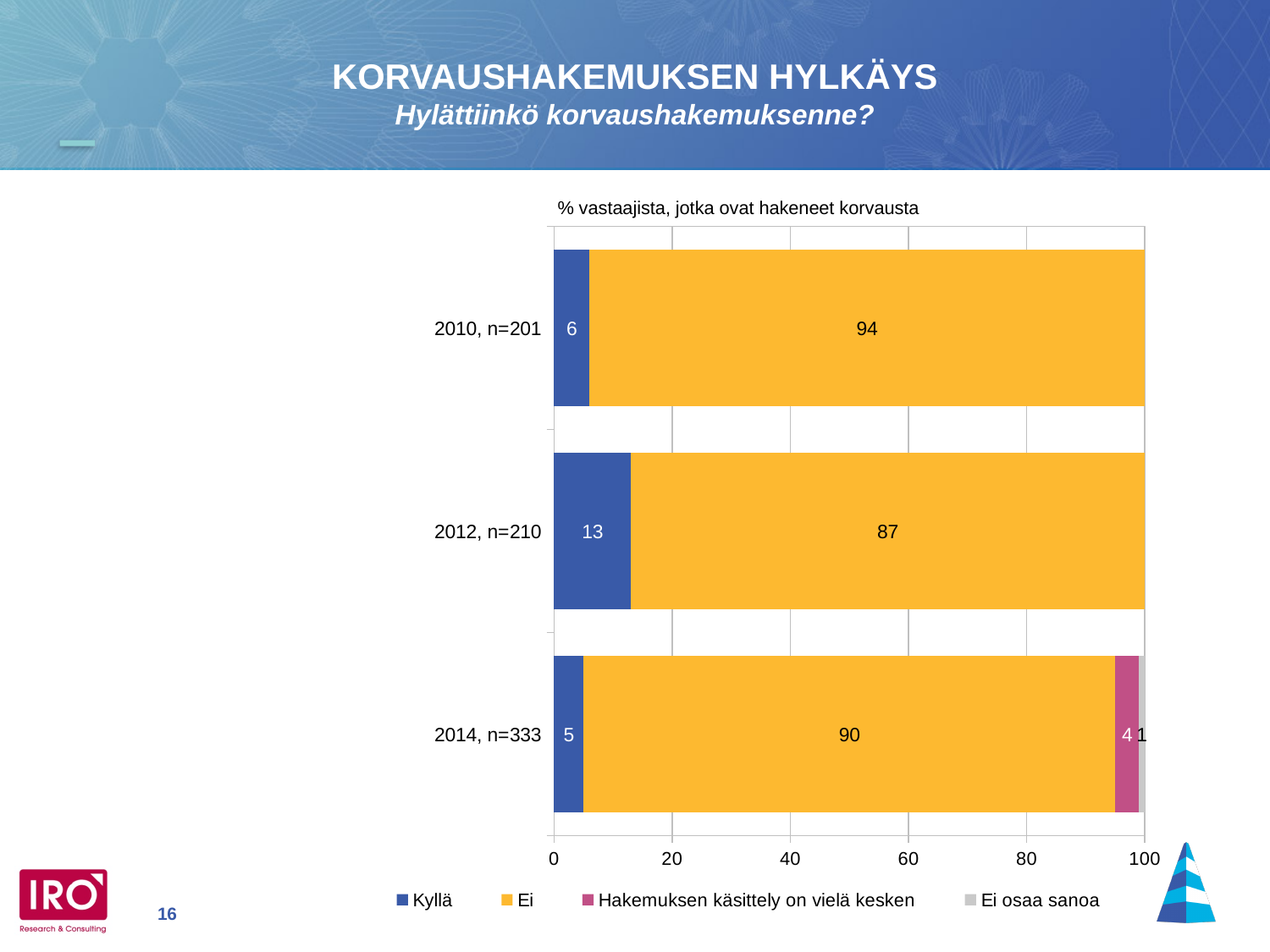
What is the total of the stacked bar for 2014, n=333? 100 Which year has the lowest value for "Ei"? 2012, n=210 How many categories (years) are shown on the chart? 3 Which is larger, the "Kyllä" value for 2010, n=201 or for 2014, n=333? 2010, n=201 Which year has the highest value for "Kyllä"? 2012, n=210 What is the value for "Ei" in 2010, n=201? 94 What is the difference between the "Ei" values for 2010, n=201 and 2012, n=210? 7 What kind of chart is shown on the slide? Stacked bar chart What is the value for "Hakemuksen käsittely on vielä kesken" in 2014, n=333? 4 What is the value for "Kyllä" in 2012, n=210? 13 How many series does the legend list? 4 What is the value for "Ei osaa sanoa" in 2014, n=333? 1